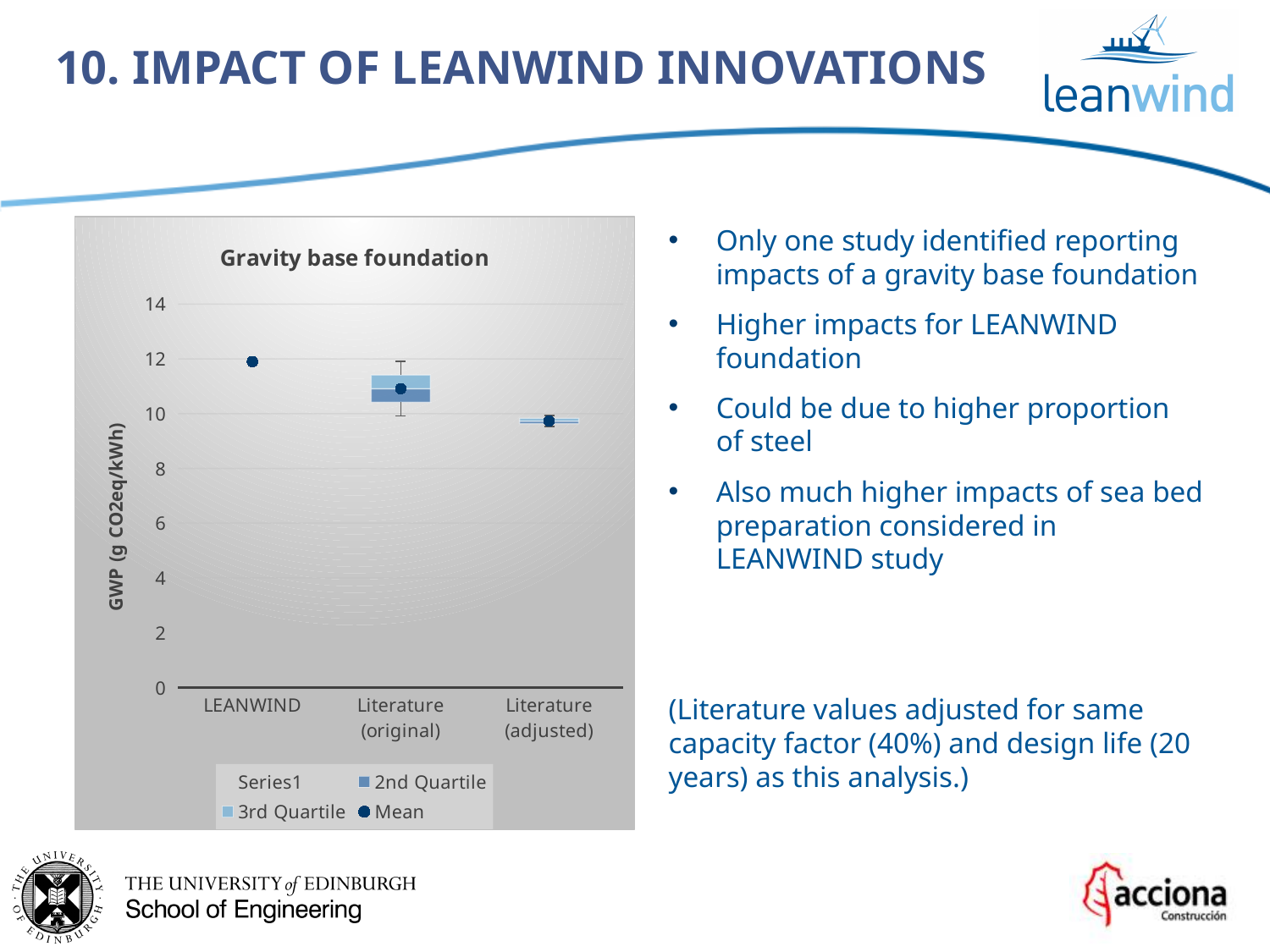
What is the label on the vertical axis of the chart? GWP (g CO2eq/kWh) Is the mean value for LEANWIND greater or less than 10? greater Which category has the lowest mean value in the chart? Literature (adjusted) What is the title of the chart? Gravity base foundation How many categories are shown on the x axis of the chart? 3 How many entries does the chart's legend list? 4 Which category has the highest mean value in the chart? LEANWIND Which has a larger mean value, Literature (original) or Literature (adjusted)? Literature (original) Which has a larger mean value, LEANWIND or Literature (original)? LEANWIND Is the mean value for Literature (original) greater or less than 12? less Is the mean value for Literature (adjusted) greater or less than 10? less Do the mean values rise or fall moving from left to right across the categories? fall